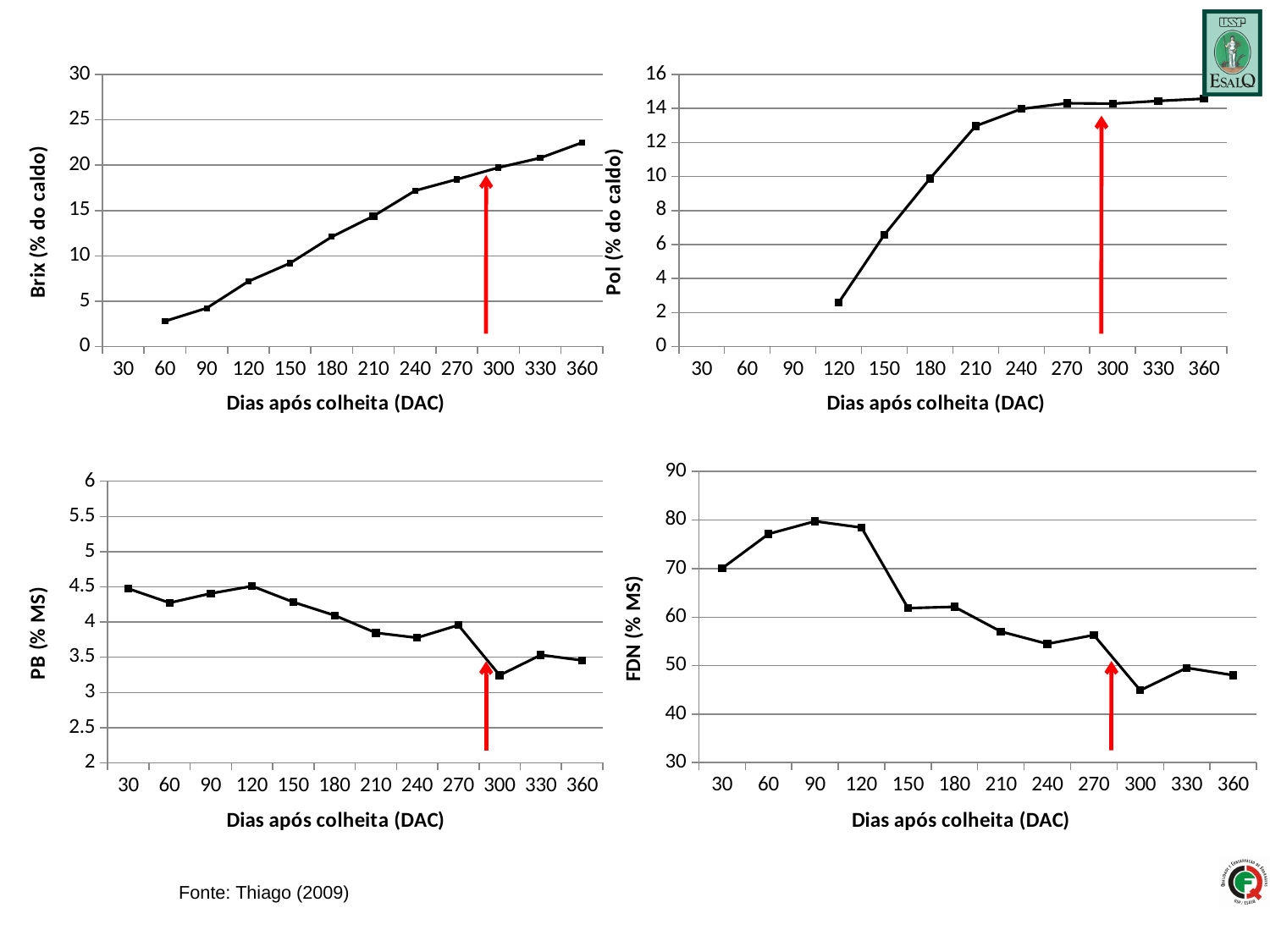
What is the x-axis label shared by all four charts? Dias após colheita (DAC) How many data points are plotted in the top-right Pol chart? 9 In the bottom-left PB chart, do the values generally rise or fall as days after harvest increase? fall In the bottom-right FDN chart, at which DAC is the value lowest? 300 In the bottom-left PB chart, at which DAC is the value lowest? 300 In the top-right Pol chart, is the value at 120 DAC greater or less than 4? less How many data points are plotted in the top-left Brix chart? 11 What kind of chart is the top-left chart (Brix, % do caldo)? line chart In the top-left Brix chart, do the values rise or fall as days after harvest increase? rise In the bottom-right FDN chart, is the value at 30 DAC greater or less than 60? greater In the top-left Brix chart, is the value at 60 DAC greater or less than 5? less In the bottom-right FDN chart, which is larger: the value at 90 DAC or the value at 360 DAC? 90 DAC